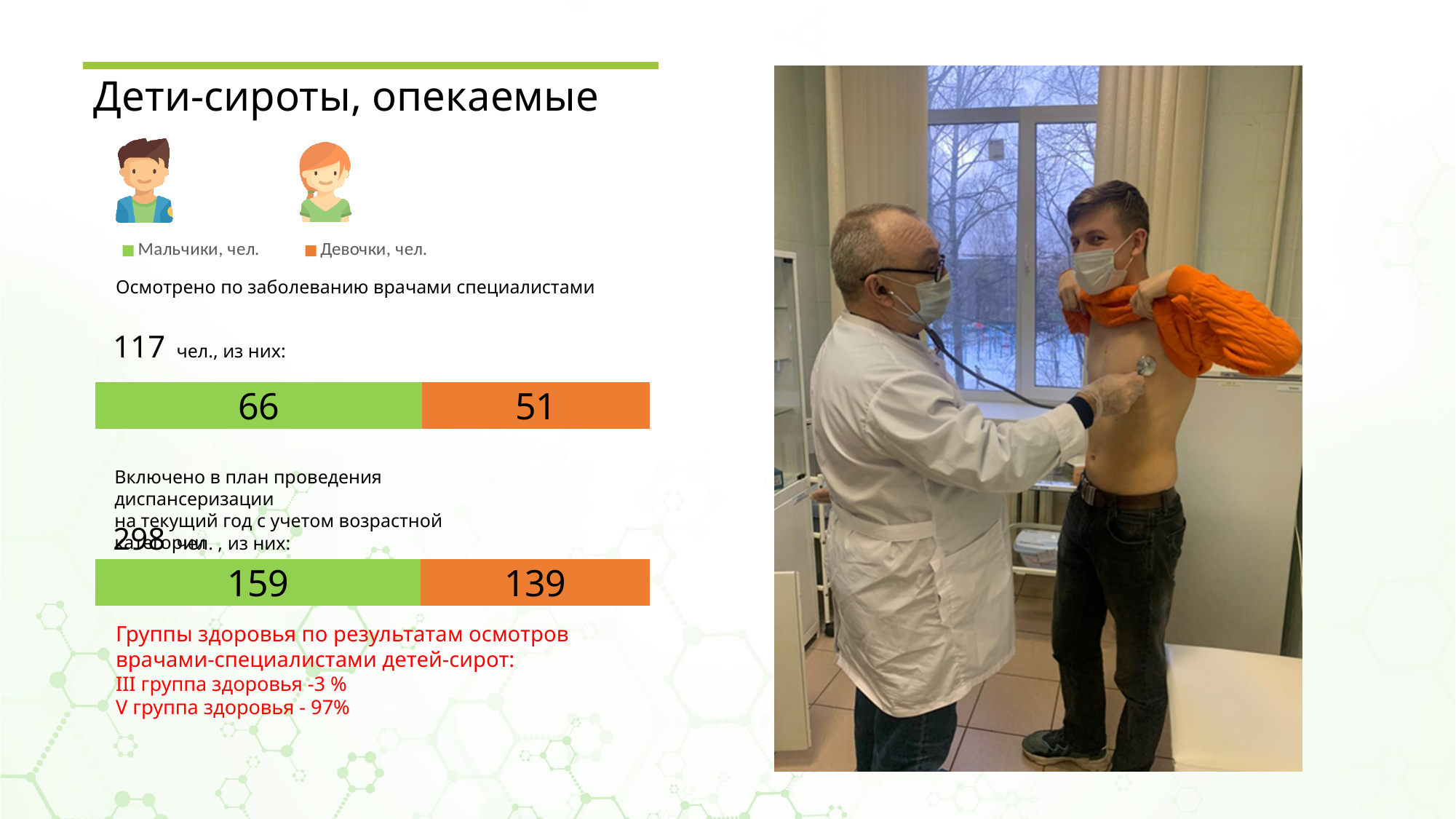
In the lower chart (Включено в план проведения диспансеризации), what is the value for Мальчики? 159 In the upper chart (Осмотрено по заболеванию врачами специалистами), what is the value for Девочки? 51 In the upper chart (Осмотрено по заболеванию врачами специалистами), what is the value for Мальчики? 66 In the upper chart, which is larger, the value for Мальчики or for Девочки? Мальчики In the lower chart, which series has the higher value? Мальчики, чел. In the lower chart, what is the total of the stacked bar? 298 What kind of chart is used to show the boys and girls figures on the slide? Stacked bar chart In the upper chart, what is the total of the stacked bar? 117 In the lower chart (Включено в план проведения диспансеризации), what is the value for Девочки? 139 In the upper chart, what is the difference between the values for Мальчики and Девочки? 15 How many series does the legend list for the charts? 2 In the lower chart, what is the difference between the values for Мальчики and Девочки? 20